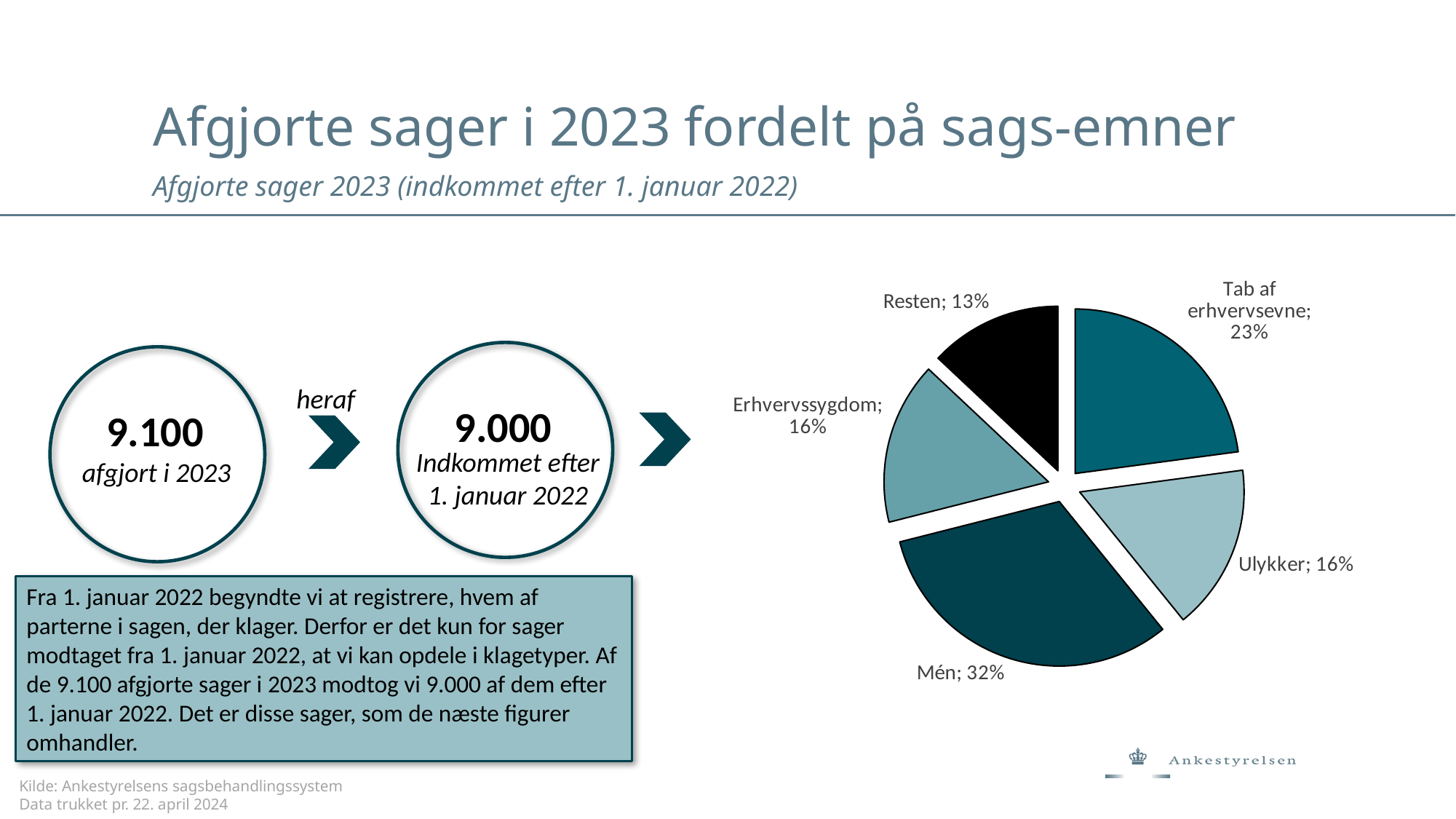
Which category has the smallest slice in the pie chart? Resten What type of chart is shown on the slide? Pie chart How many percentage points larger is the Mén slice than the Tab af erhvervsevne slice? 9 What share of the pie chart does Resten account for? 13% What is the combined share of Ulykker and Erhvervssygdom in the pie chart? 32% What share of the pie chart does Tab af erhvervsevne account for? 23% What share of the pie chart does Erhvervssygdom account for? 16% What share of the pie chart does Mén account for? 32% Which slice of the pie chart is coloured black? Resten Which category has the largest slice in the pie chart? Mén Which slice is larger, Tab af erhvervsevne or Ulykker? Tab af erhvervsevne How many slices does the pie chart have? 5